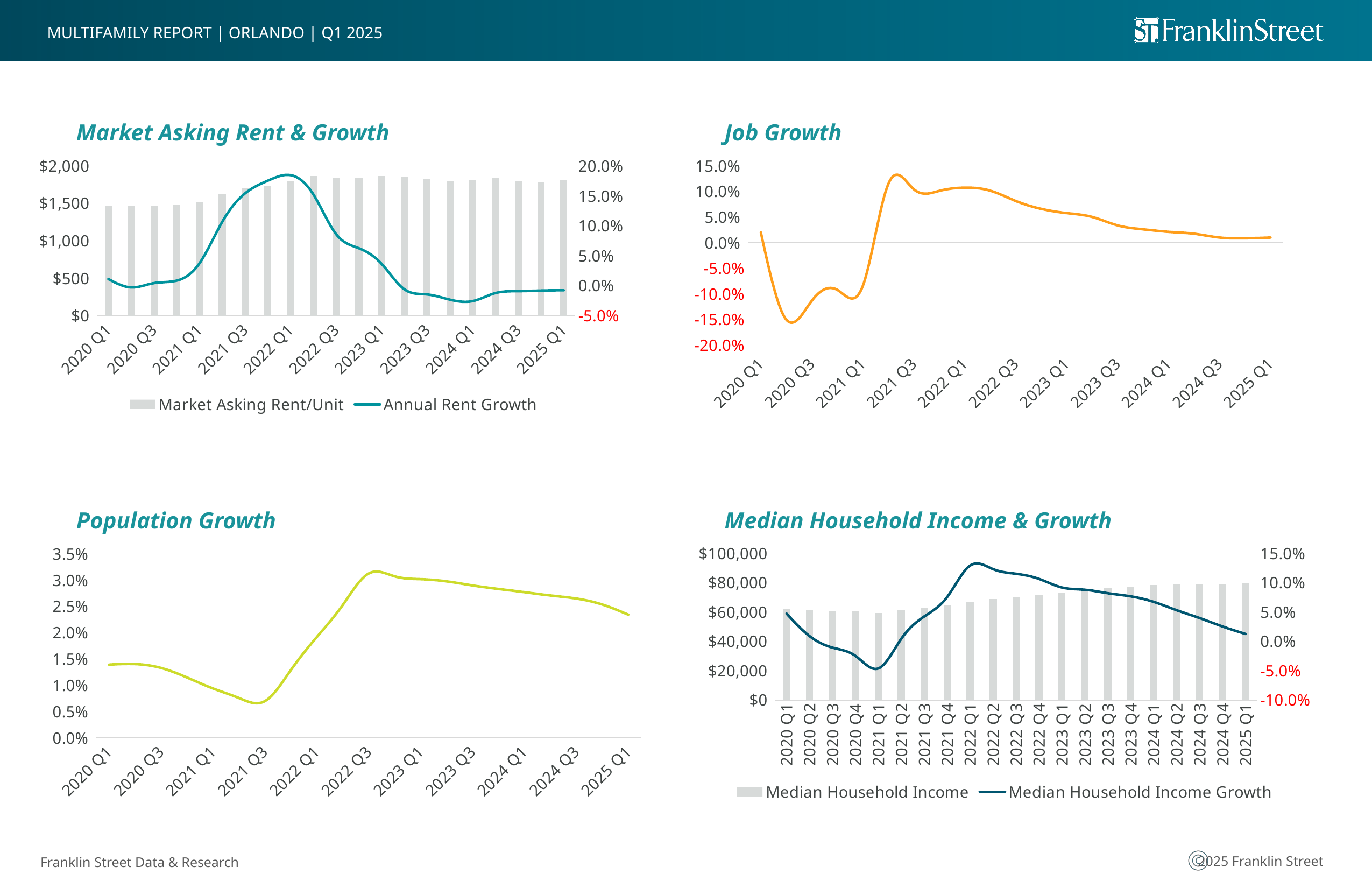
In the Population Growth chart, is the value for 2021 Q3 greater or less than 1.0%? less In the Job Growth chart, does the line rise or fall from 2022 Q1 to 2025 Q1? fall In the Median Household Income & Growth chart, is the Median Household Income for 2025 Q1 greater or less than $60,000? greater In the Market Asking Rent & Growth chart, is the Market Asking Rent/Unit for 2020 Q1 greater or less than $1,000? greater In the Market Asking Rent & Growth chart, what kind of chart is used to show Market Asking Rent/Unit? bar chart In the Market Asking Rent & Growth chart, which is larger, the Market Asking Rent/Unit for 2020 Q1 or for 2025 Q1? 2025 Q1 In the Median Household Income & Growth chart, how many bars are plotted? 21 In the Market Asking Rent & Growth chart, how many series does the legend list? 2 In the Population Growth chart, what kind of chart is shown? line chart